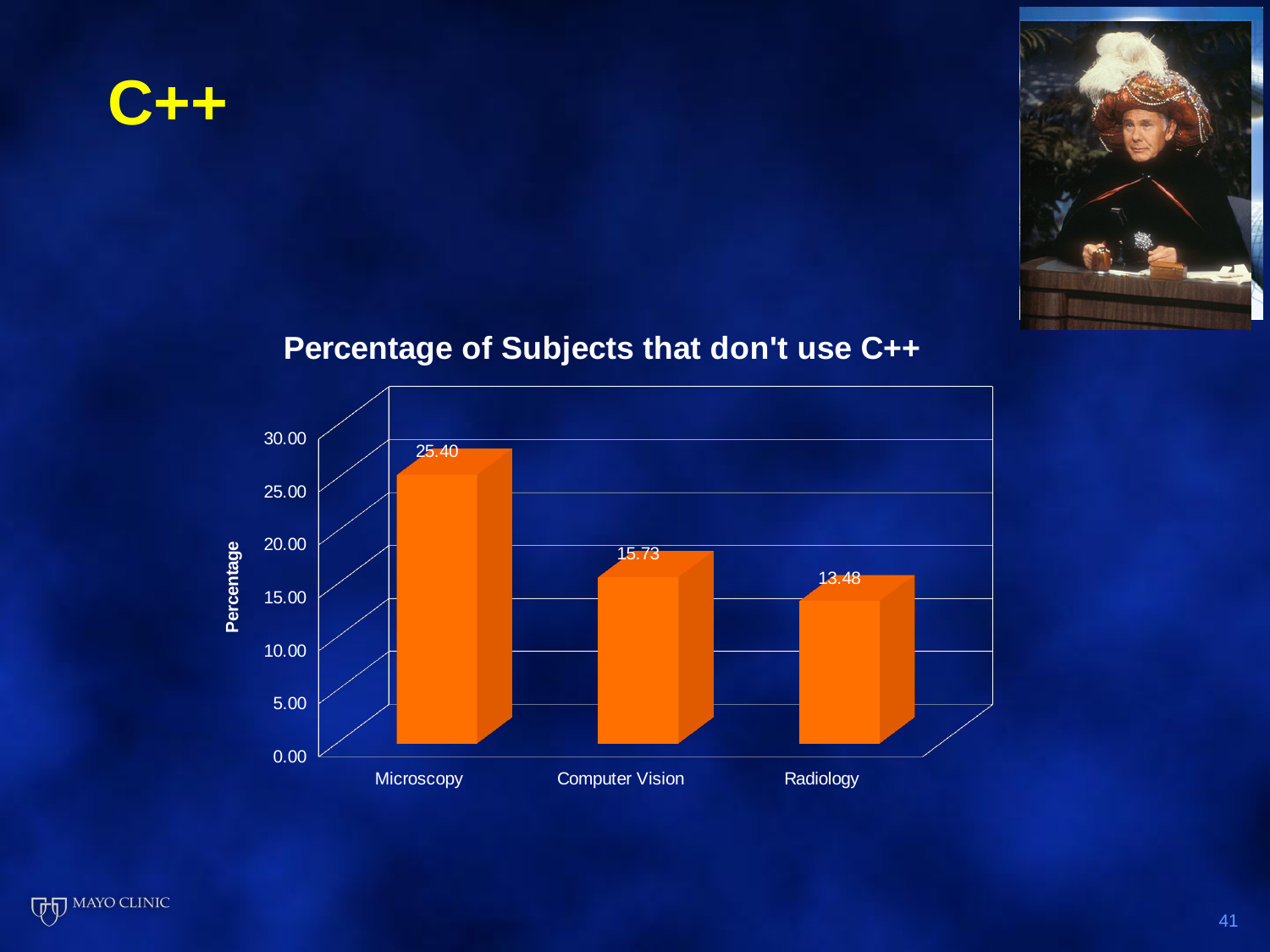
How many categories are shown in the chart? 3 What is the difference between the values for Computer Vision and Radiology? 2.25 Is the value for Microscopy greater or less than 20.00? greater Which category has the lowest percentage? Radiology What kind of chart is shown on the slide? bar chart Which is larger, the value for Microscopy or the value for Radiology? Microscopy What is the difference between the values for Microscopy and Computer Vision? 9.67 What is the value for Radiology? 13.48 What is the value for Computer Vision? 15.73 What is the title of the chart? Percentage of Subjects that don't use C++ Which category has the highest percentage? Microscopy What is the value for Microscopy? 25.40